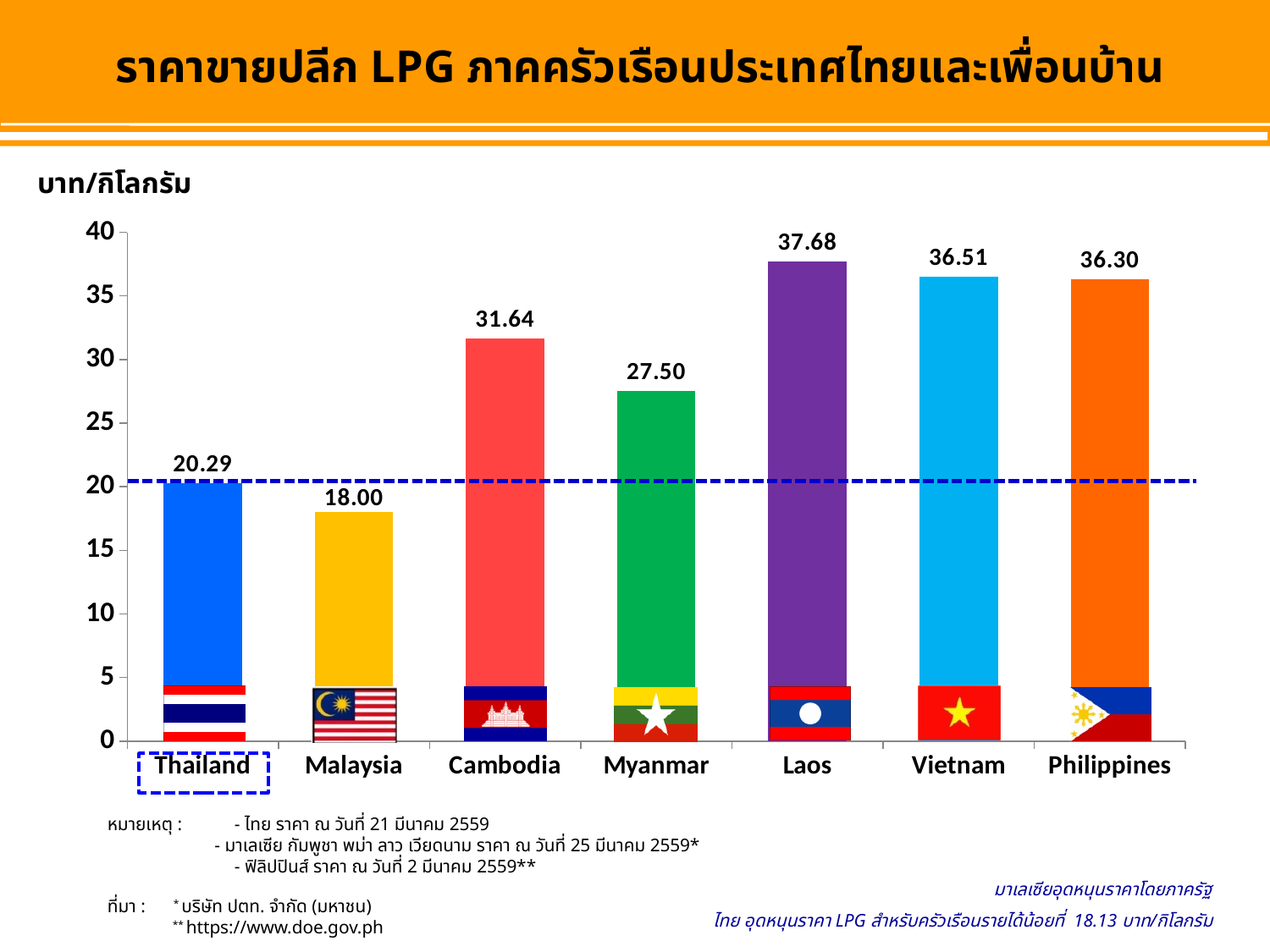
What unit is shown above the y axis of the chart? บาท/กิโลกรัม Which country has the lowest LPG price on the chart? Malaysia What is the LPG retail price shown for Thailand? 20.29 What is the value shown for Myanmar? 27.50 What is the value shown for Laos? 37.68 Is the value for Cambodia greater or less than 30? greater Which is larger, the value for Vietnam or the value for Philippines? Vietnam How many countries are shown on the chart? 7 What is the difference between the values for Laos and Thailand? 17.39 What is the difference between the values for Cambodia and Malaysia? 13.64 What kind of chart is shown on the slide? bar chart Which country has the highest LPG price on the chart? Laos